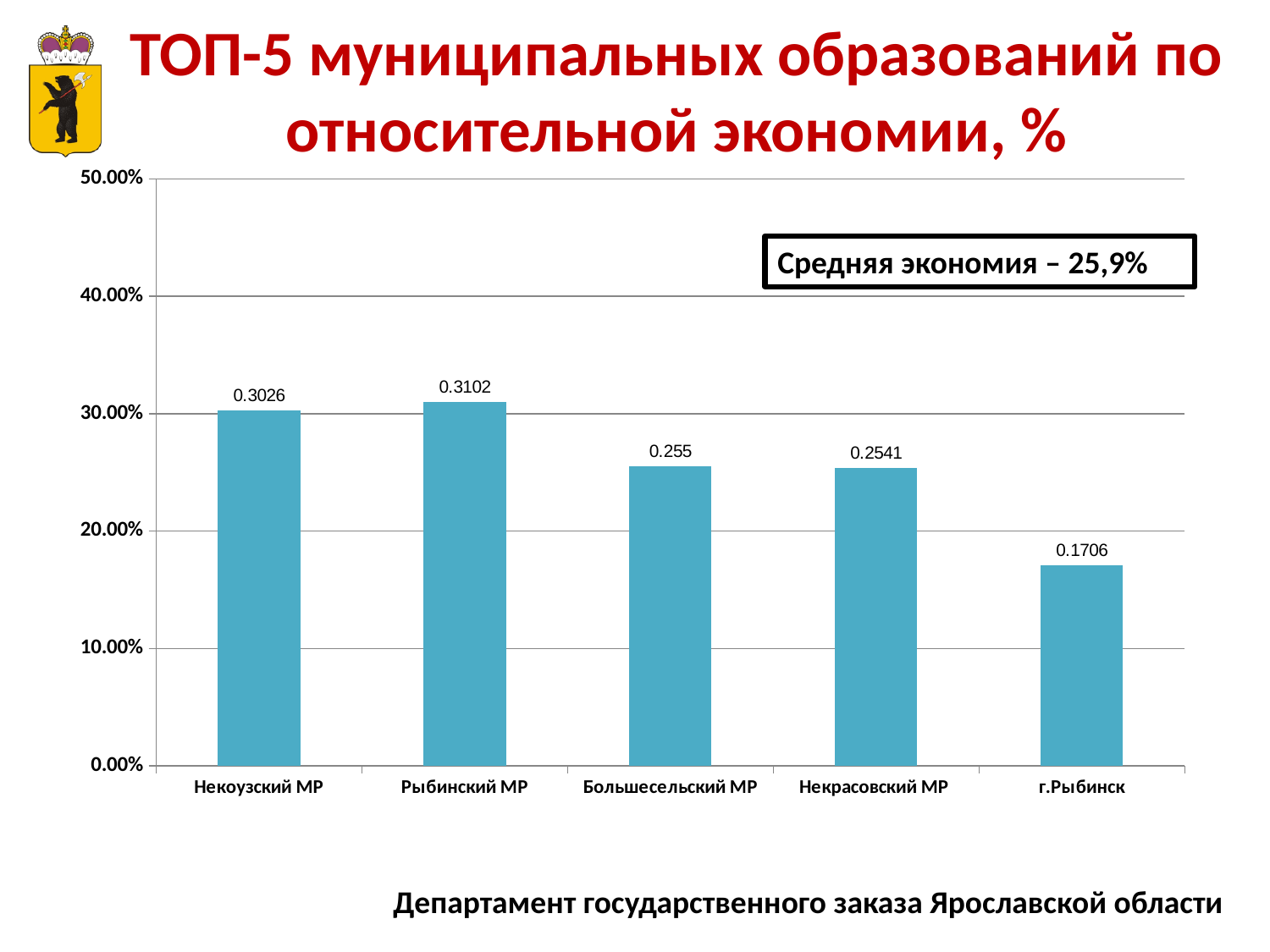
Which is larger, the value for Некоузский МР or the value for Рыбинский МР? Рыбинский МР What kind of chart is shown on the slide? bar chart What average saving (Средняя экономия) is stated in the box on the chart? 25,9% What is the difference between the values for Рыбинский МР and г.Рыбинск? 0.1396 Which municipality has the lowest value on the chart? г.Рыбинск How many municipalities are shown on the chart? 5 What is the value shown for г.Рыбинск? 0.1706 Which municipality has the highest value on the chart? Рыбинский МР What is the value shown for Большесельский МР? 0.255 What is the value shown for Рыбинский МР? 0.3102 What is the value shown for Некоузский МР? 0.3026 Is the value for г.Рыбинск greater or less than 20.00%? less